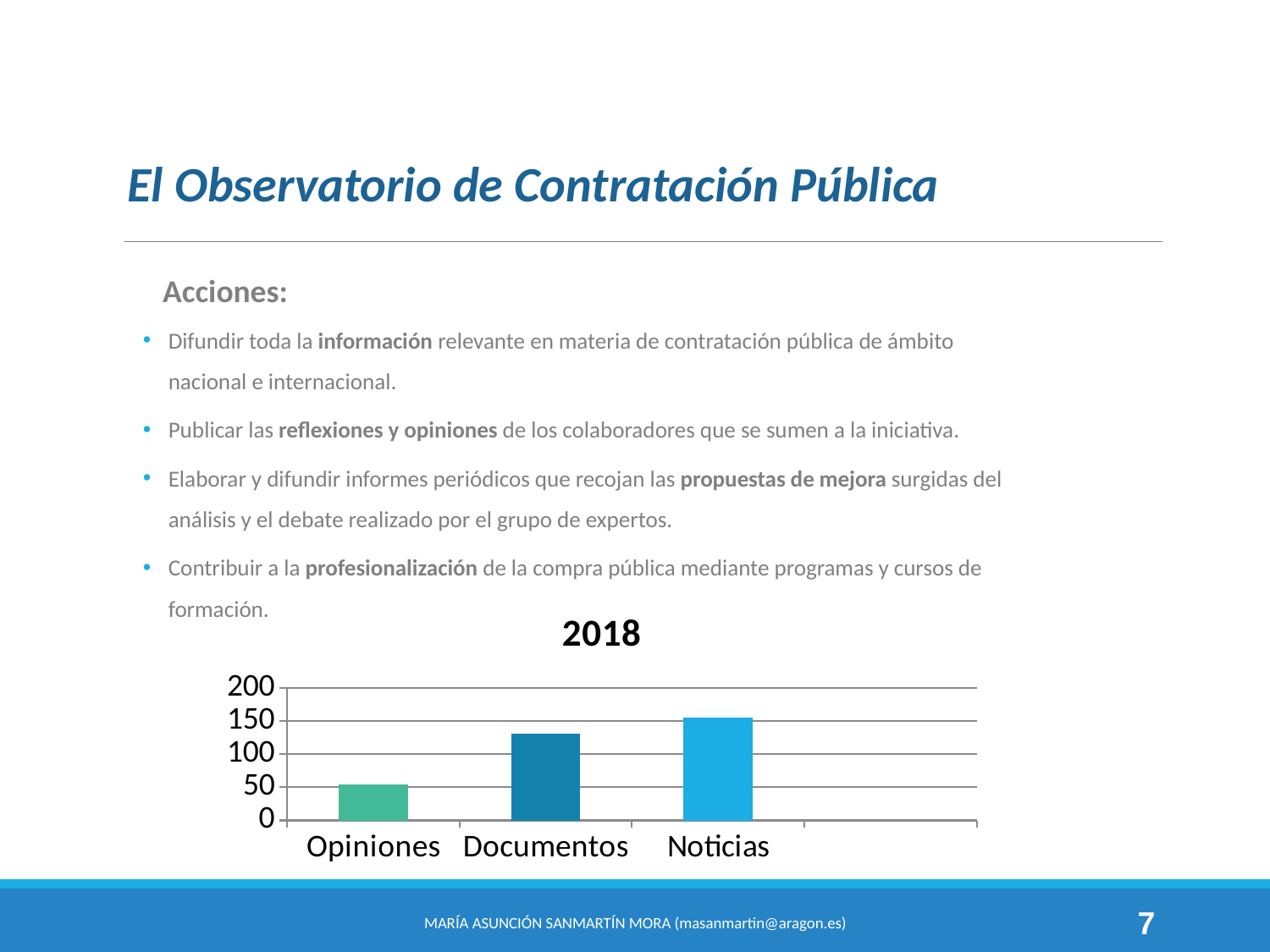
Which category has the highest value in the chart? Noticias Is the value for Documentos greater or less than 100? greater Is the value for Documentos greater or less than 150? less Which is larger, the value for Noticias or the value for Documentos? Noticias How many categories are shown on the x axis of the chart? 3 What kind of chart is shown on the slide? bar chart Is the value for Opiniones greater or less than 100? less Which is larger, the value for Documentos or the value for Opiniones? Documentos Do the values rise or fall from left to right across the categories? rise What is the title of the chart? 2018 Which category has the lowest value in the chart? Opiniones